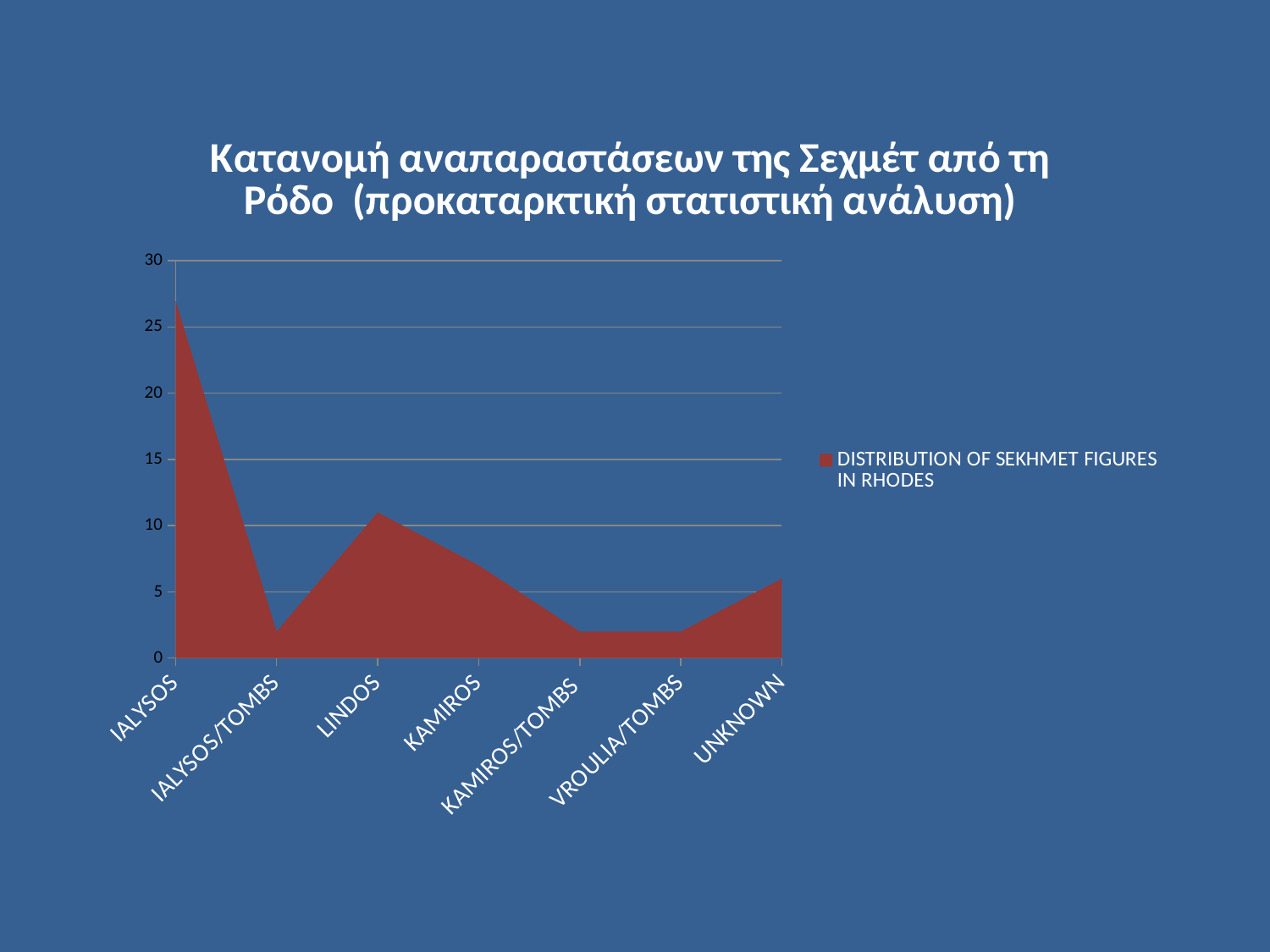
Does the value rise or fall from IALYSOS to IALYSOS/TOMBS? fall What kind of chart is shown on the slide? Area chart Which has the larger value, IALYSOS or LINDOS? IALYSOS How many categories are shown on the x axis? 7 Is the value for UNKNOWN greater or less than 10? less What series name is shown in the legend? DISTRIBUTION OF SEKHMET FIGURES IN RHODES How many series does the legend list? 1 Which has the larger value, LINDOS or KAMIROS? LINDOS Is the value for KAMIROS greater or less than 10? less Which category has the highest value? IALYSOS Is the value for IALYSOS greater or less than 25? greater